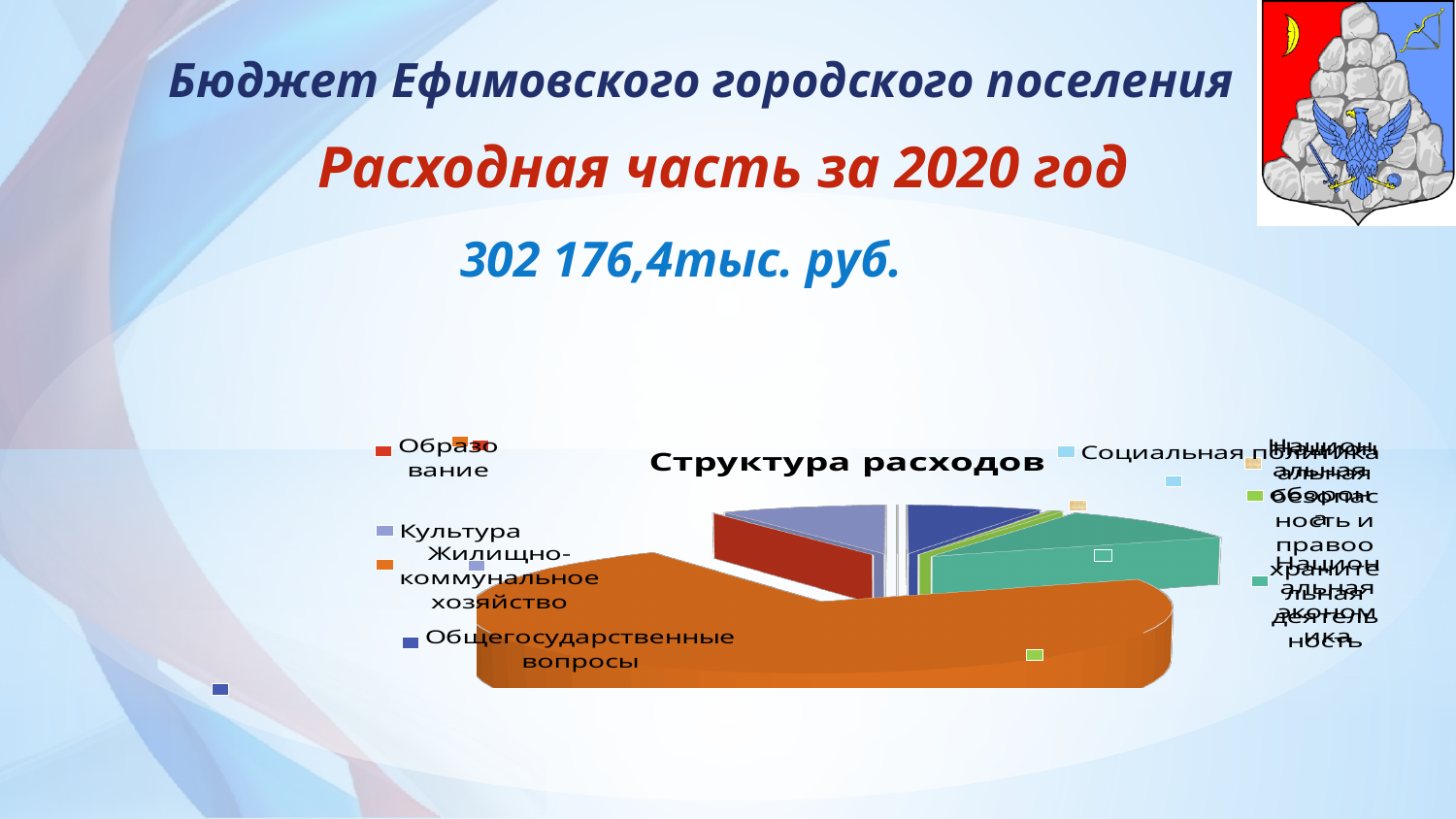
What is the title of the chart on the slide? Структура расходов Which slice is larger in the pie chart: Жилищно-коммунальное хозяйство or Образование? Жилищно-коммунальное хозяйство What colour is the slice for Жилищно-коммунальное хозяйство in the pie chart? orange Which category has the largest slice in the pie chart? Жилищно-коммунальное хозяйство What kind of chart is shown on the slide? pie chart